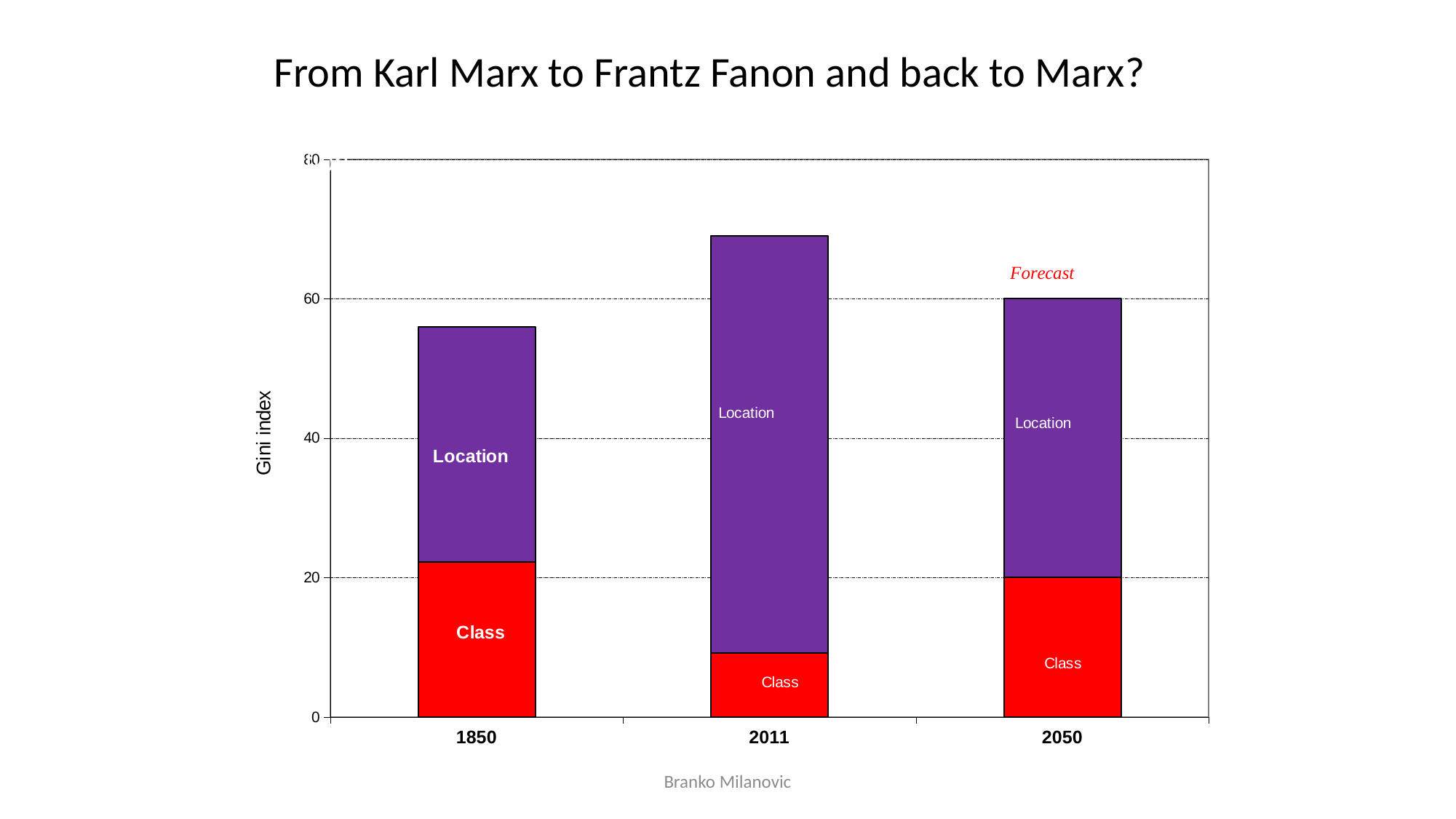
Is the total Gini index for 1850 greater or less than 60? less What kind of chart is shown on the slide? Stacked bar chart Is the Class segment for 2011 greater or less than 20? less What is the label on the y axis? Gini index Which year has the highest total Gini index? 2011 Which year has the smallest Class segment? 2011 How many years (categories) are shown on the x axis? 3 Is the total Gini index for 2011 greater or less than 60? greater Which is larger, the total Gini index for 2011 or for 1850? 2011 How many series (segments) make up each stacked bar? 2 Which year has the lowest total Gini index? 1850 Which year has the largest Class segment? 1850